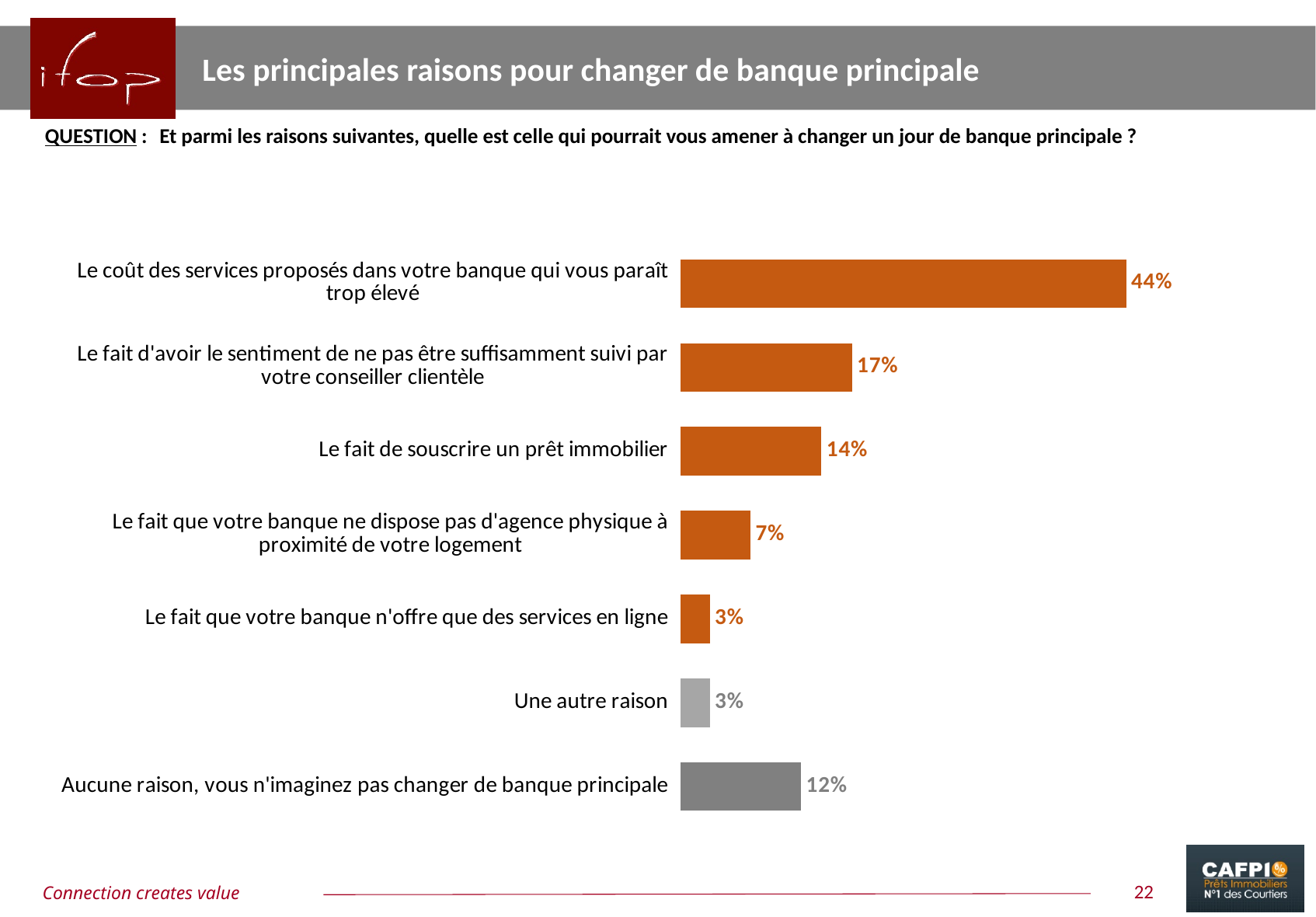
Which is larger: the value for "Le fait de souscrire un prêt immobilier" or the value for "Aucune raison, vous n'imaginez pas changer de banque principale"? Le fait de souscrire un prêt immobilier What value is shown for "Le fait de souscrire un prêt immobilier"? 14% What is the title of the slide containing the chart? Les principales raisons pour changer de banque principale What is the difference between the value for "Le fait que votre banque ne dispose pas d'agence physique à proximité de votre logement" and the value for "Le fait que votre banque n'offre que des services en ligne"? 4 percentage points What percentage is shown for "Le coût des services proposés dans votre banque qui vous paraît trop élevé"? 44% What kind of chart is shown on the slide? Bar chart How many categories (bars) does the chart show? 7 What is the difference between the value for "Le coût des services proposés dans votre banque qui vous paraît trop élevé" and the value for "Le fait d'avoir le sentiment de ne pas être suffisamment suivi par votre conseiller clientèle"? 27 percentage points What colour is the bar for "Aucune raison, vous n'imaginez pas changer de banque principale"? Grey Which reason has the highest percentage? Le coût des services proposés dans votre banque qui vous paraît trop élevé What percentage is shown for "Aucune raison, vous n'imaginez pas changer de banque principale"? 12% What value is shown for "Le fait que votre banque ne dispose pas d'agence physique à proximité de votre logement"? 7%